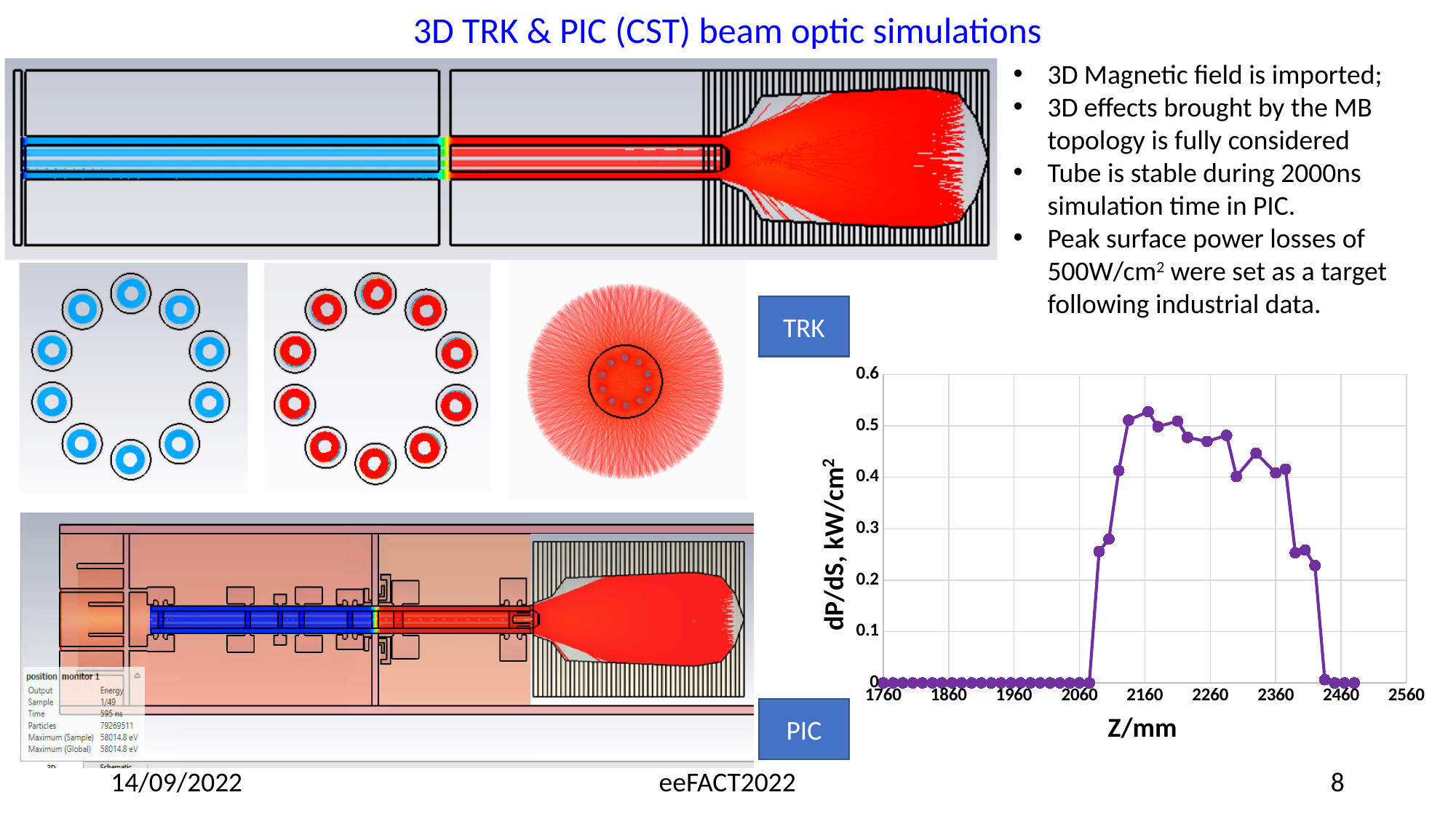
Is the value of dP/dS at Z = 1860 mm greater or less than 0.1? less Is the value of dP/dS at Z = 2360 mm greater or less than 0.3? greater Is the value of dP/dS at Z = 2260 mm greater or less than 0.4? greater What is the label of the x axis of the chart? Z/mm Do the values rise or fall along the x axis between Z = 2360 mm and Z = 2460 mm? fall What is the label of the y axis of the chart? dP/dS, kW/cm² What kind of chart is shown on the slide? line chart Around which x-axis tick does the curve reach its highest value? 2160 Do the values rise or fall along the x axis between Z = 2060 mm and Z = 2160 mm? rise